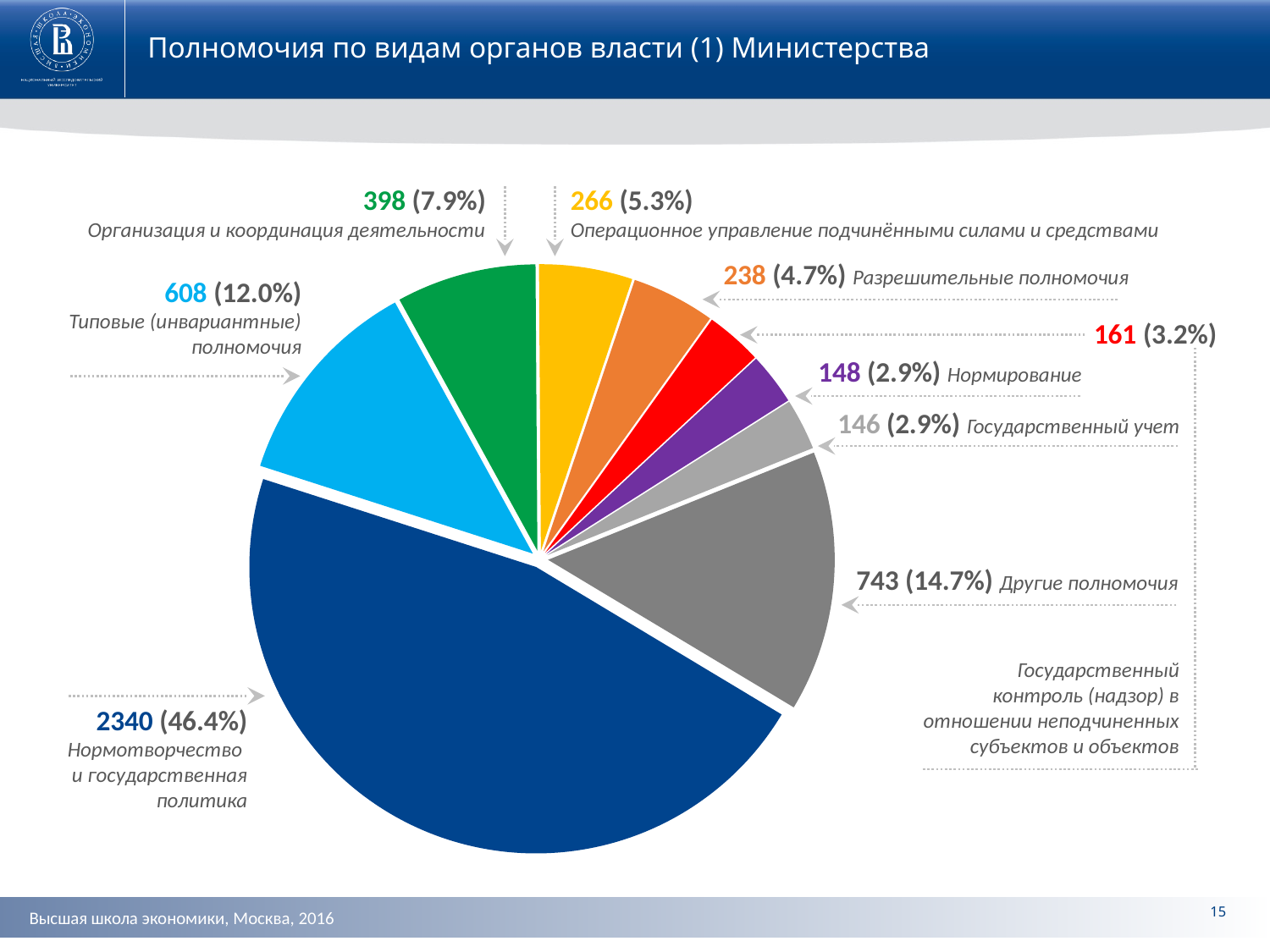
What is the value for Разрешительные полномочия? 238 What share of the pie does Типовые (инвариантные) полномочия take? 12.0% What is the value for Другие полномочия? 743 Which category has the largest slice of the pie? Нормотворчество и государственная политика What is the value for Нормотворчество и государственная политика? 2340 What kind of chart is shown on the slide? pie chart What is the difference between the values for Другие полномочия and Типовые (инвариантные) полномочия? 135 Which is larger: the value for Организация и координация деятельности or the value for Операционное управление подчинёнными силами и средствами? Организация и координация деятельности What is the share of the pie for Государственный контроль (надзор) в отношении неподчиненных субъектов и объектов? 3.2% How many slices does the pie chart have? 9 Which category has the smallest slice of the pie? Государственный учет What share of the pie does Нормотворчество и государственная политика take? 46.4%